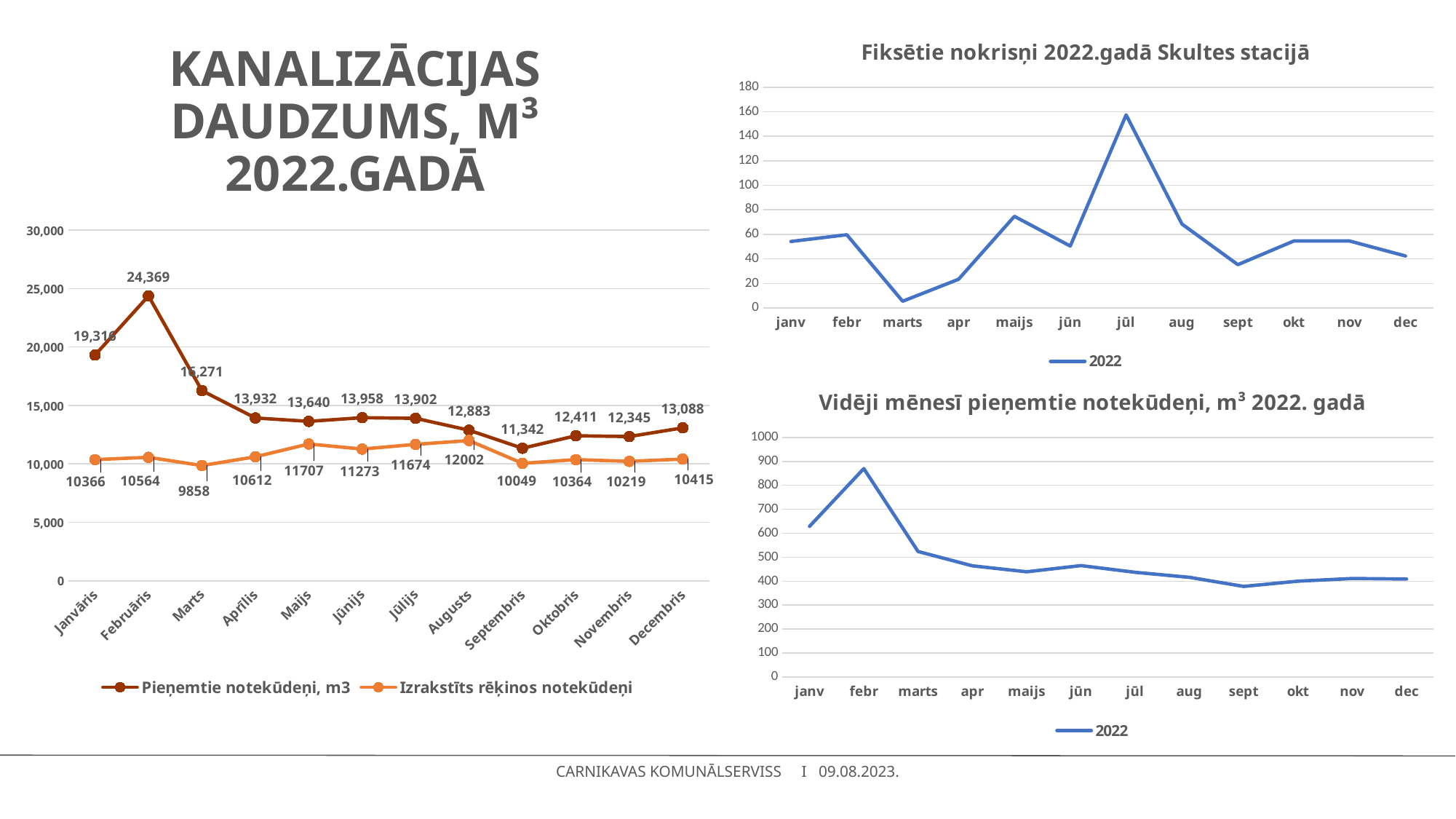
In the chart titled 'Fiksētie nokrisņi 2022.gadā Skultes stacijā', which month has the highest value? jūl In the chart titled 'Fiksētie nokrisņi 2022.gadā Skultes stacijā', is the value for jūl greater or less than 140? greater In the chart titled 'Vidēji mēnesī pieņemtie notekūdeņi, m³ 2022. gadā', which month has the highest value? febr In the chart titled 'KANALIZĀCIJAS DAUDZUMS, M³ 2022.GADĀ', what is the value of 'Pieņemtie notekūdeņi, m3' for Februāris? 24,369 What kind of chart is the chart titled 'Fiksētie nokrisņi 2022.gadā Skultes stacijā'? Line chart How many series does the legend of the chart titled 'KANALIZĀCIJAS DAUDZUMS, M³ 2022.GADĀ' list? 2 In the chart titled 'KANALIZĀCIJAS DAUDZUMS, M³ 2022.GADĀ', is the 'Pieņemtie notekūdeņi, m3' value higher in Jūnijs or Jūlijs? Jūnijs In the chart titled 'KANALIZĀCIJAS DAUDZUMS, M³ 2022.GADĀ', which month has the highest value for 'Pieņemtie notekūdeņi, m3'? Februāris In the chart titled 'KANALIZĀCIJAS DAUDZUMS, M³ 2022.GADĀ', what is the difference between 'Pieņemtie notekūdeņi, m3' and 'Izrakstīts rēķinos notekūdeņi' in Aprīlis? 3,320 In the chart titled 'KANALIZĀCIJAS DAUDZUMS, M³ 2022.GADĀ', what is the value of 'Izrakstīts rēķinos notekūdeņi' for Maijs? 11707 In the chart titled 'Vidēji mēnesī pieņemtie notekūdeņi, m³ 2022. gadā', is the value for sept greater or less than 400? less In the chart titled 'KANALIZĀCIJAS DAUDZUMS, M³ 2022.GADĀ', which month has the lowest value for 'Izrakstīts rēķinos notekūdeņi'? Marts